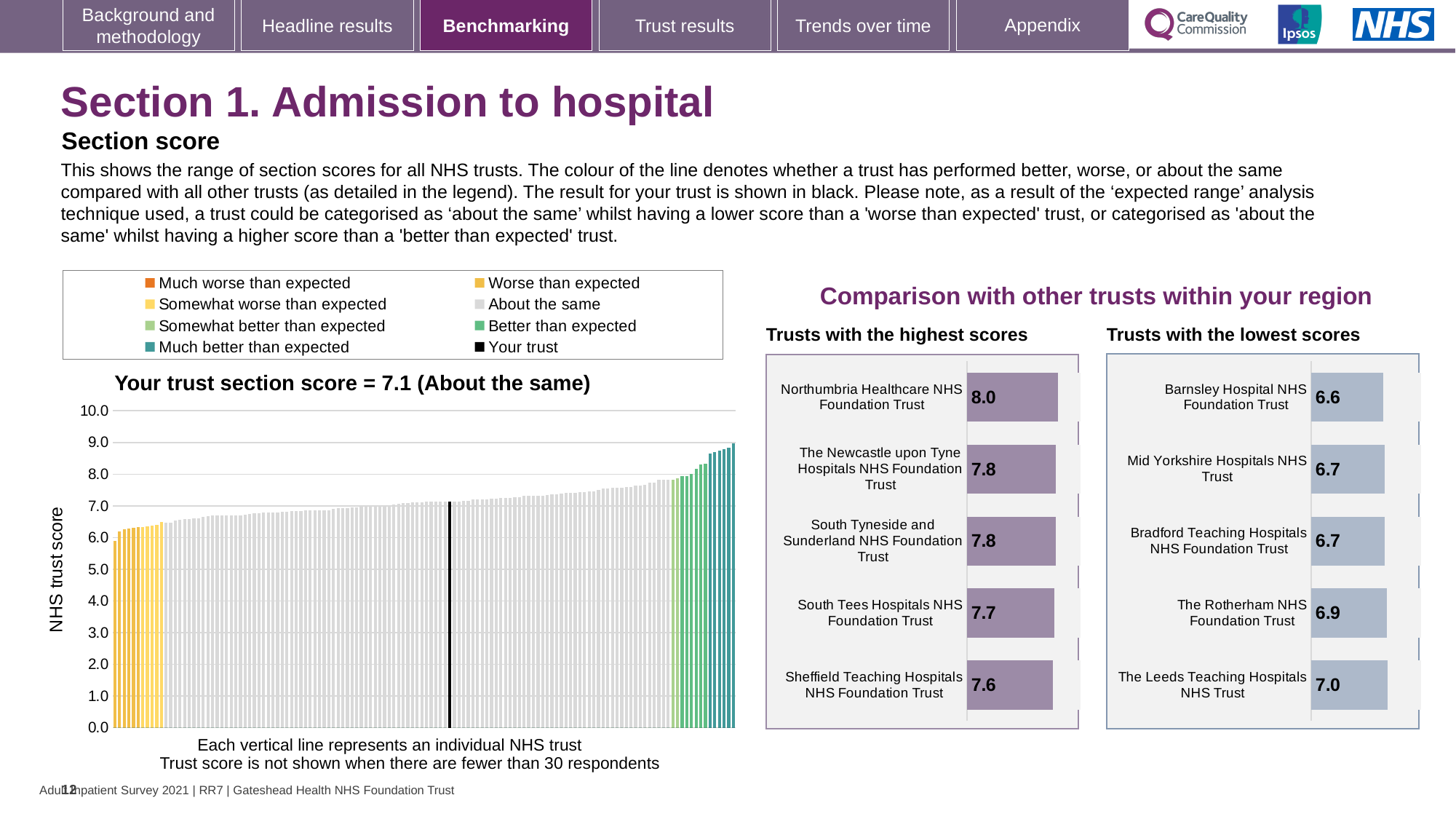
In the 'Trusts with the highest scores' chart, what is the score for Sheffield Teaching Hospitals NHS Foundation Trust? 7.6 In the 'Your trust section score' chart, what is the section score for your trust? 7.1 In the 'Trusts with the lowest scores' chart, which trust has the lowest score? Barnsley Hospital NHS Foundation Trust In the 'Your trust section score' chart, do the trust scores rise or fall from left to right along the x axis? Rise What kind of chart is the 'Your trust section score = 7.1 (About the same)' chart? Bar chart In the 'Your trust section score' chart, is the value of the rightmost bar greater or less than 8.0? greater How many trusts are listed in the 'Trusts with the highest scores' chart? 5 In the 'Trusts with the lowest scores' chart, what is the difference between the scores of The Leeds Teaching Hospitals NHS Trust and Barnsley Hospital NHS Foundation Trust? 0.4 In the 'Trusts with the lowest scores' chart, what is the score for The Rotherham NHS Foundation Trust? 6.9 In the 'Trusts with the lowest scores' chart, which has the larger score: The Rotherham NHS Foundation Trust or Mid Yorkshire Hospitals NHS Trust? The Rotherham NHS Foundation Trust In the 'Trusts with the highest scores' chart, which trust has the highest score? Northumbria Healthcare NHS Foundation Trust In the 'Trusts with the highest scores' chart, what is the score for Northumbria Healthcare NHS Foundation Trust? 8.0